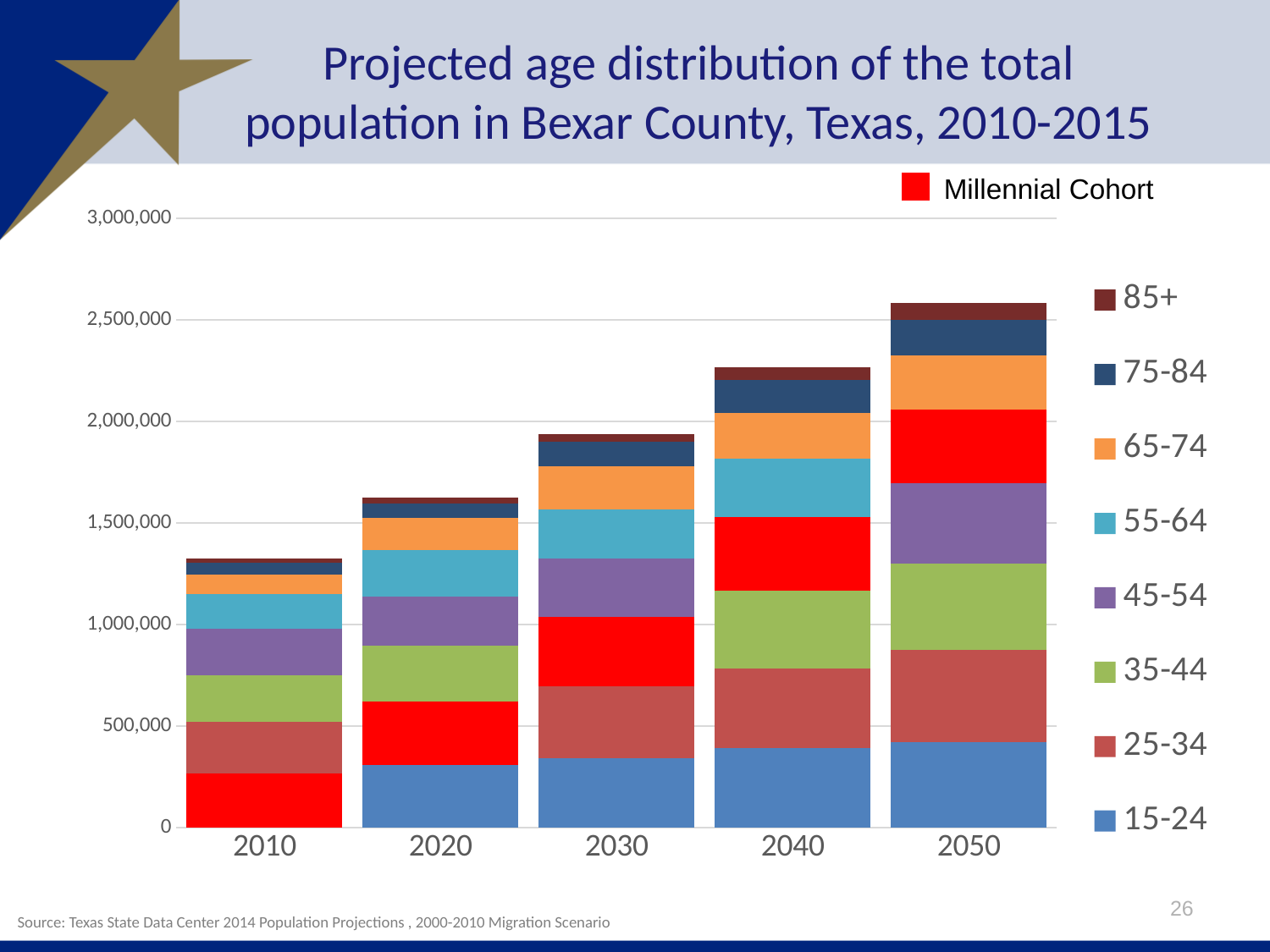
How many age groups does the main legend on the right list? 8 Which age group is listed at the top of the main legend on the right? 85+ Is the total projected population for 2040 greater or less than 2,000,000? greater Is the total projected population for 2010 greater or less than 1,500,000? less How many years are shown along the x axis of the chart? 5 Which year has the highest total projected population? 2050 Is the total projected population for 2050 greater or less than 2,500,000? greater Which year has the lowest total projected population? 2010 What does the red colour in the bars represent, according to the legend at the top? Millennial Cohort Which year has a larger total projected population, 2030 or 2040? 2040 What kind of chart is shown on the slide? Stacked bar chart Do the total bar heights rise or fall from 2010 to 2050? Rise